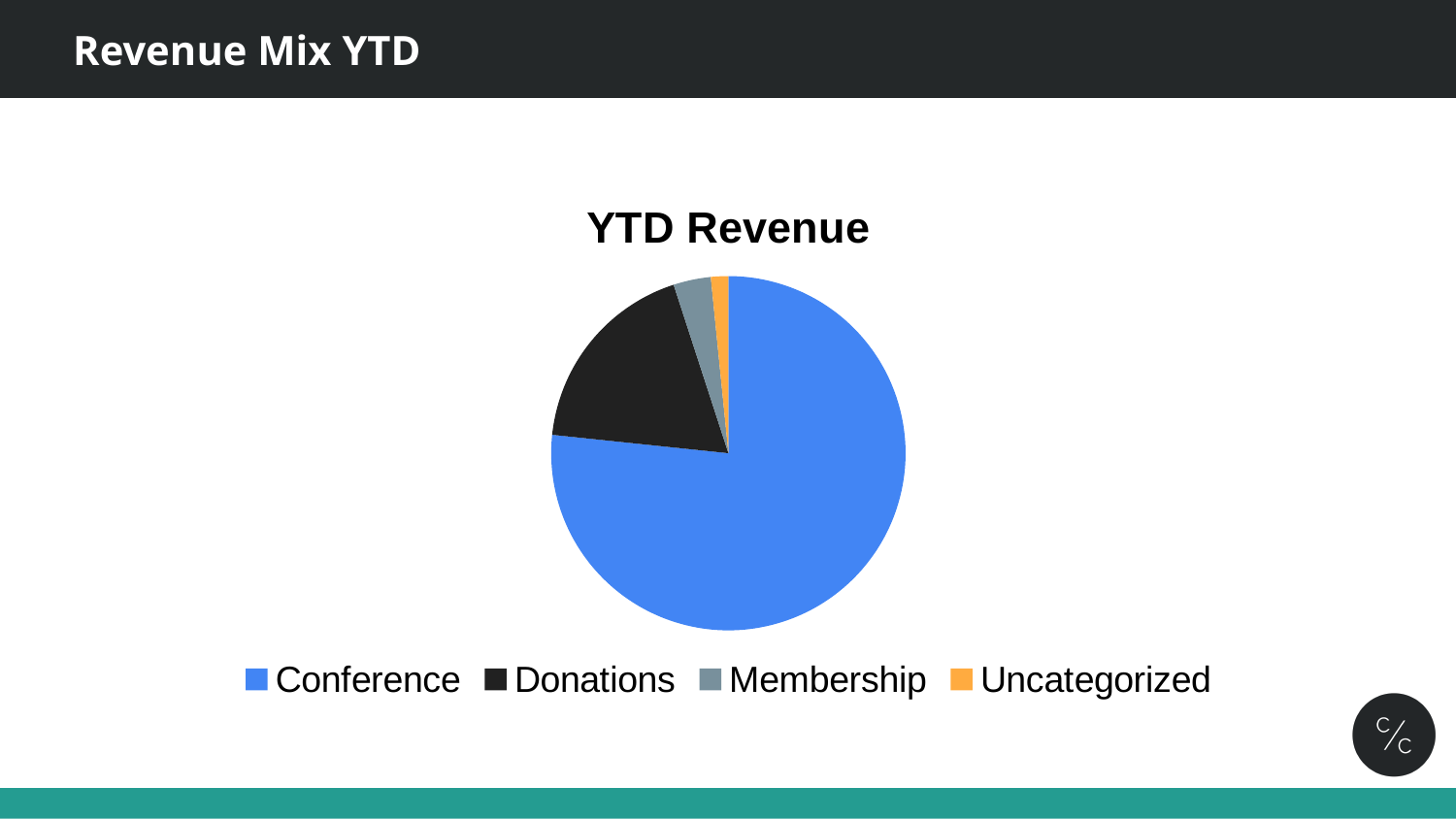
What is the title of the chart? YTD Revenue Which category is shown in orange in the legend? Uncategorized Which category has the largest slice of the pie? Conference How many categories does the pie chart show? 4 Which category is the second-largest slice of the pie? Donations Which is larger, the Conference slice or the Donations slice? Conference Which category has the smallest slice of the pie? Uncategorized What kind of chart is shown on the slide? pie chart Which is larger, the Donations slice or the Membership slice? Donations What colour is the Conference slice in the pie chart? blue Which is larger, the Membership slice or the Conference slice? Conference